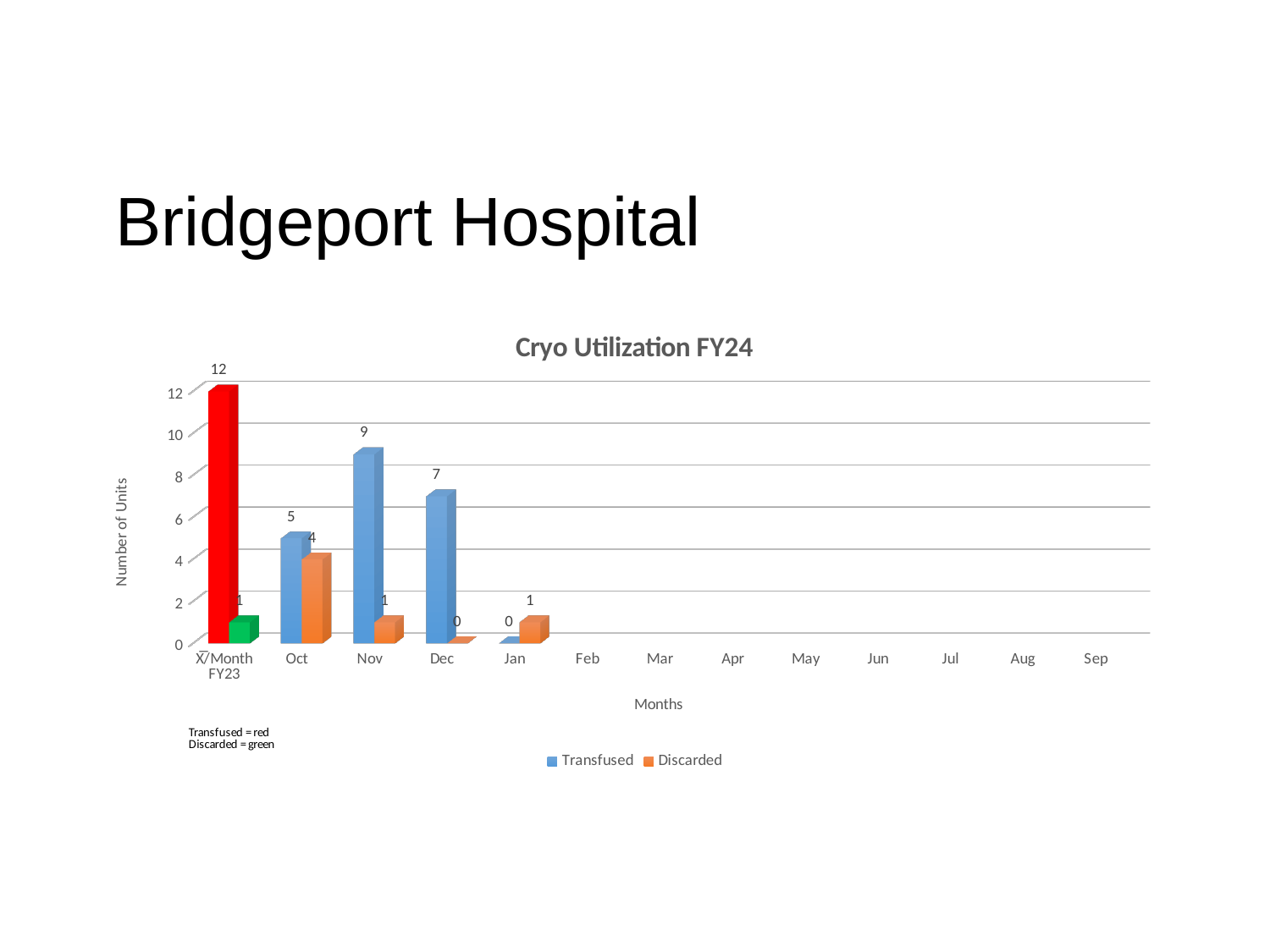
How many categories are shown on the x axis of the chart? 13 Which month from Oct to Jan has the lowest Transfused value? Jan What kind of chart is shown on the slide? Bar chart What is the Transfused value for Nov? 9 What is the Transfused value for Dec? 7 What is the Discarded value for Oct? 4 How many series does the chart legend list? 2 What is the difference between the Transfused values for Nov and Dec? 2 What is the title of the chart? Cryo Utilization FY24 Which category has the highest Transfused value? X̄/Month FY23 Do the Transfused values rise or fall from Nov to Jan? Fall Which is larger, the Transfused value for Oct or the Discarded value for Oct? Transfused for Oct